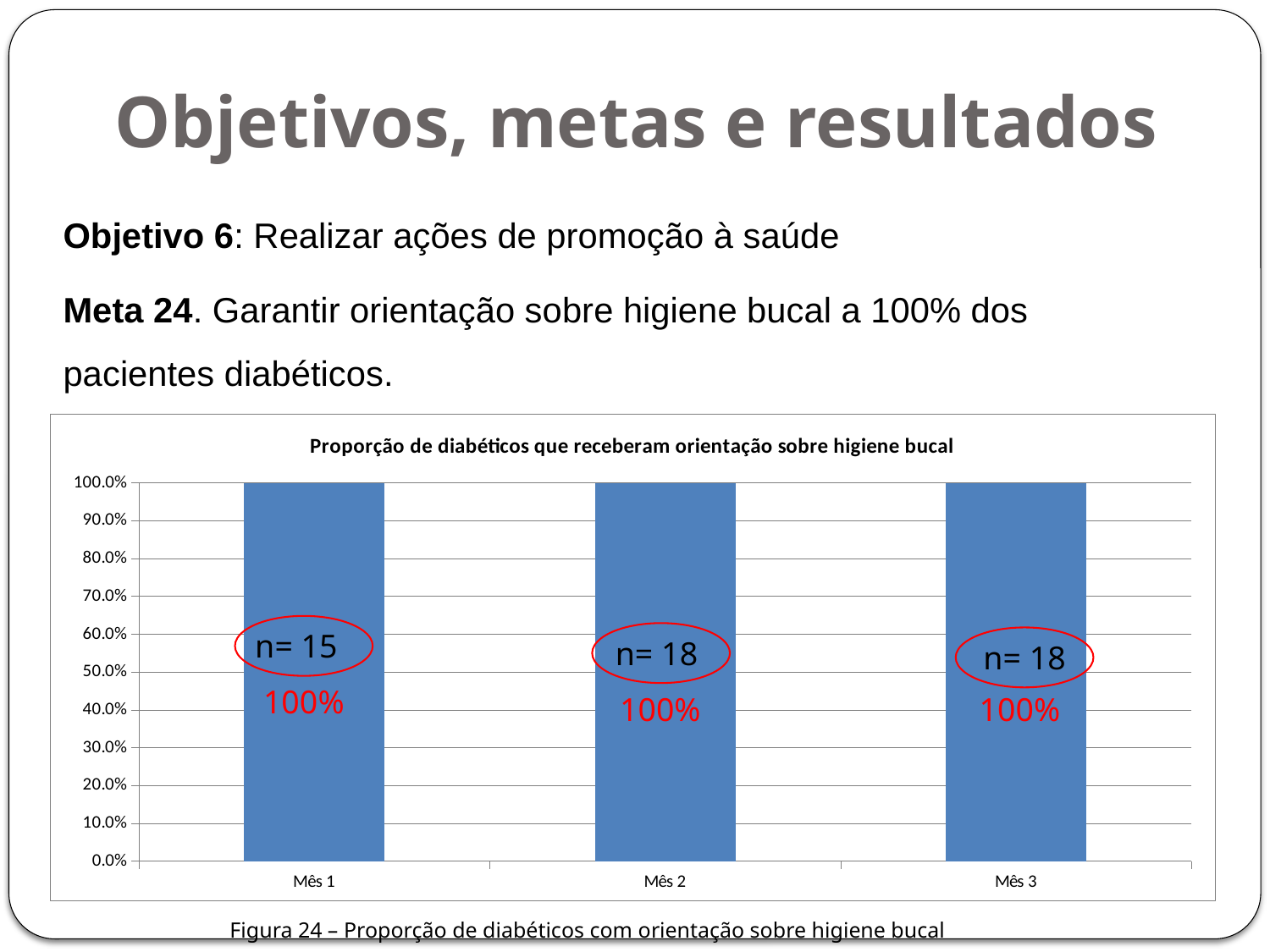
What is the n value shown for Mês 1? n= 15 What is the value for Mês 2? 100% What is the n value shown for Mês 3? n= 18 What is the value for Mês 1? 100% What is the difference between the values for Mês 1 and Mês 3? 0% Is the value for Mês 2 greater or less than 90.0%? greater What is the value for Mês 3? 100% What is the n value shown for Mês 2? n= 18 How many categories are shown on the x axis? 3 What is the title of the chart? Proporção de diabéticos que receberam orientação sobre higiene bucal Do the values rise, fall or stay the same from Mês 1 to Mês 3? stay the same What kind of chart is this? bar chart